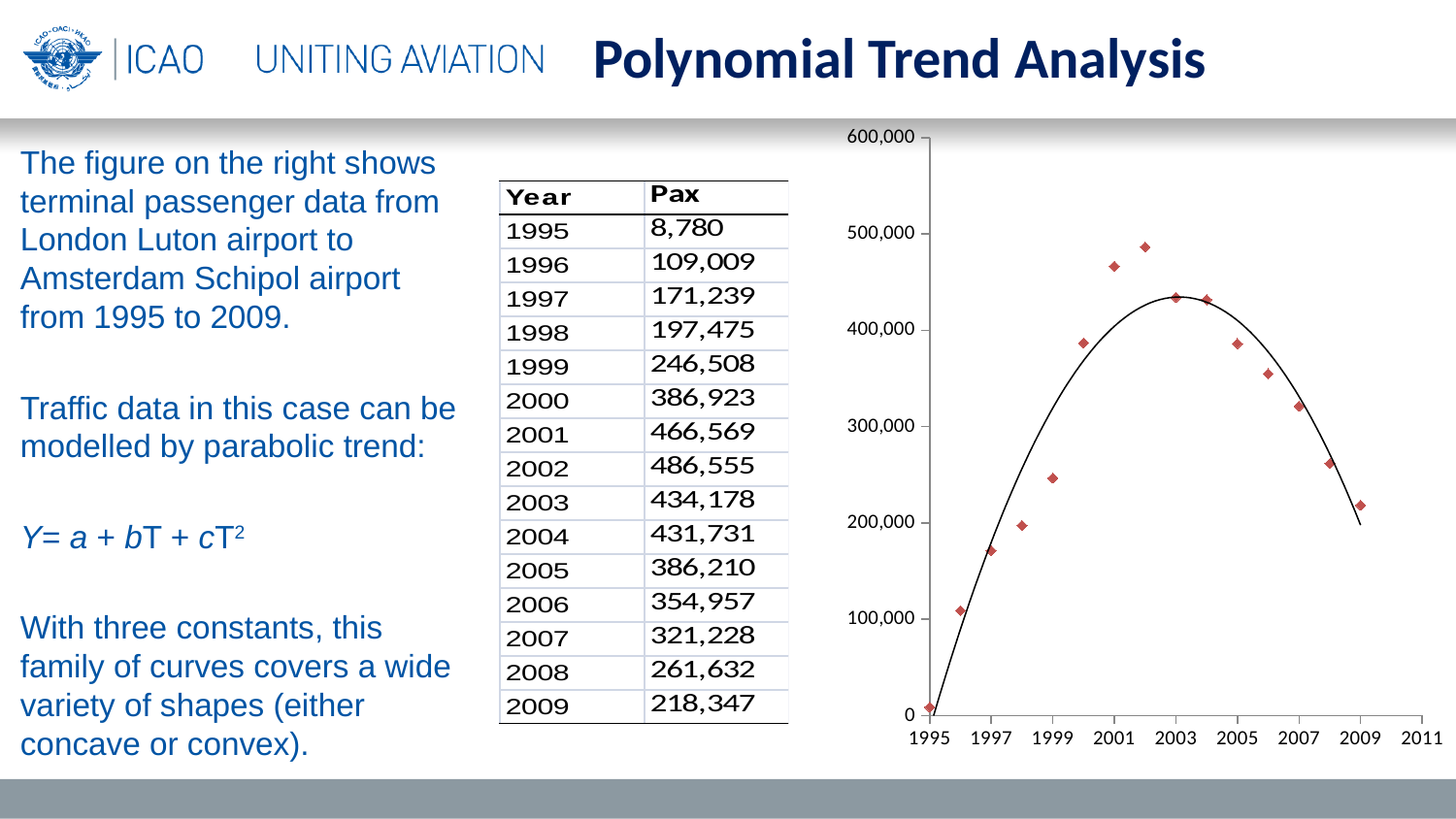
What kind of chart is shown on the right of the slide? scatter chart with a trend line According to the table, what was the passenger value for 2009? 218,347 What is the difference between the passenger values for 2002 and 2009? 268,208 Do the plotted values rise or fall from 2003 to 2009? fall Is the plotted value for 2008 greater or less than 300,000? less Is the plotted value for 2001 greater or less than 400,000? greater Which year has the larger passenger value, 2000 or 2005? 2000 How many data points are plotted on the chart? 15 According to the table, what was the passenger value for 1995? 8,780 According to the table, what was the passenger value for 2002? 486,555 Which year has the highest passenger value? 2002 Which year has the lowest passenger value? 1995